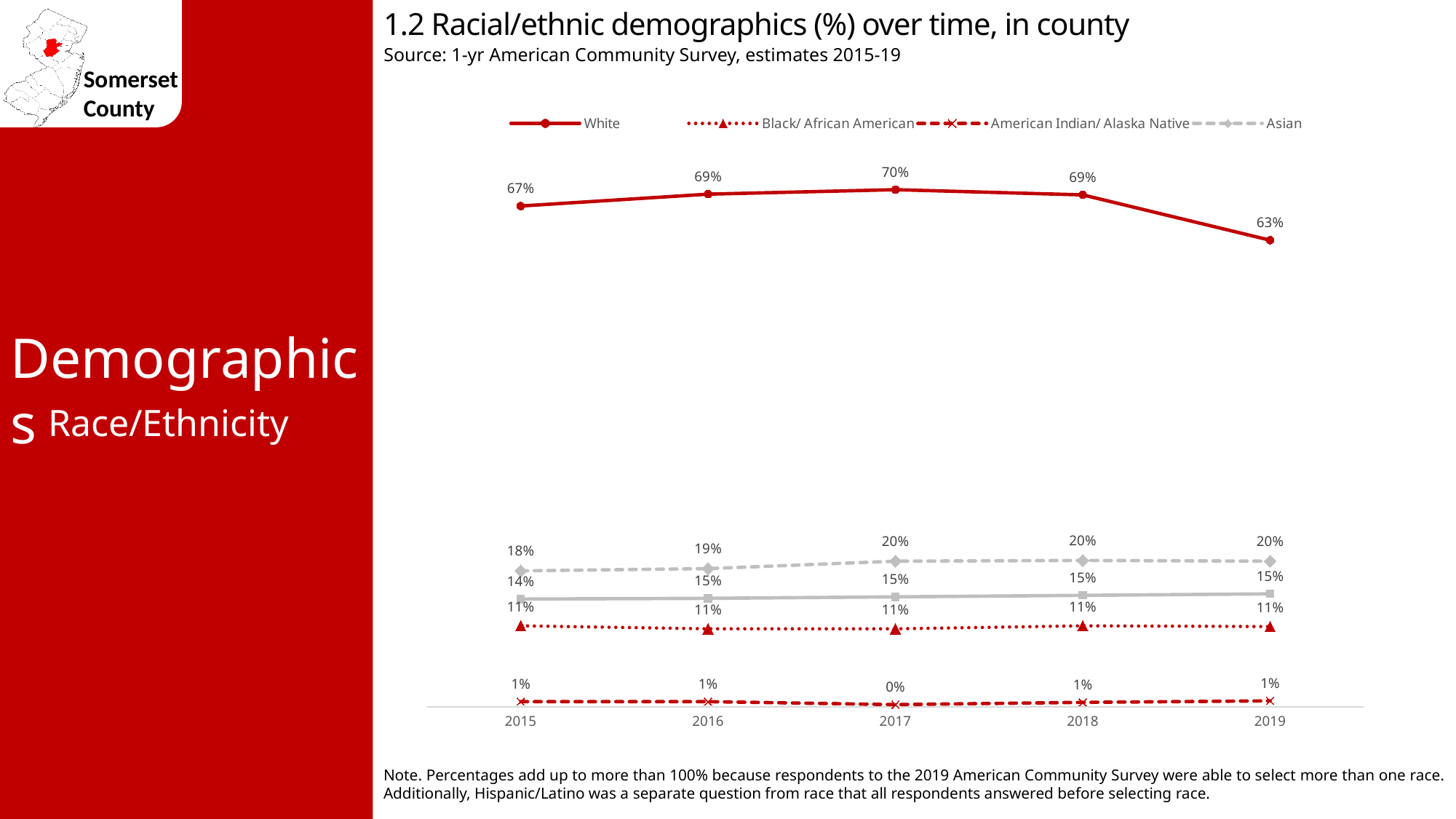
What is the value for American Indian/ Alaska Native in 2017? 0% How many series does the legend list? 4 In which year is the White series at its lowest? 2019 What is the value for White in 2019? 63% Which is larger in 2019, the Asian value or the Black/ African American value? Asian Does the Asian series rise or fall from 2015 to 2019? Rise What is the value for Asian in 2015? 18% What is the difference between the White value in 2015 and in 2019? 4 percentage points How many years are shown on the x axis? 5 What kind of chart is shown on the slide? Line chart In which year is the White series at its highest? 2017 What is the value for Black/ African American in 2018? 11%